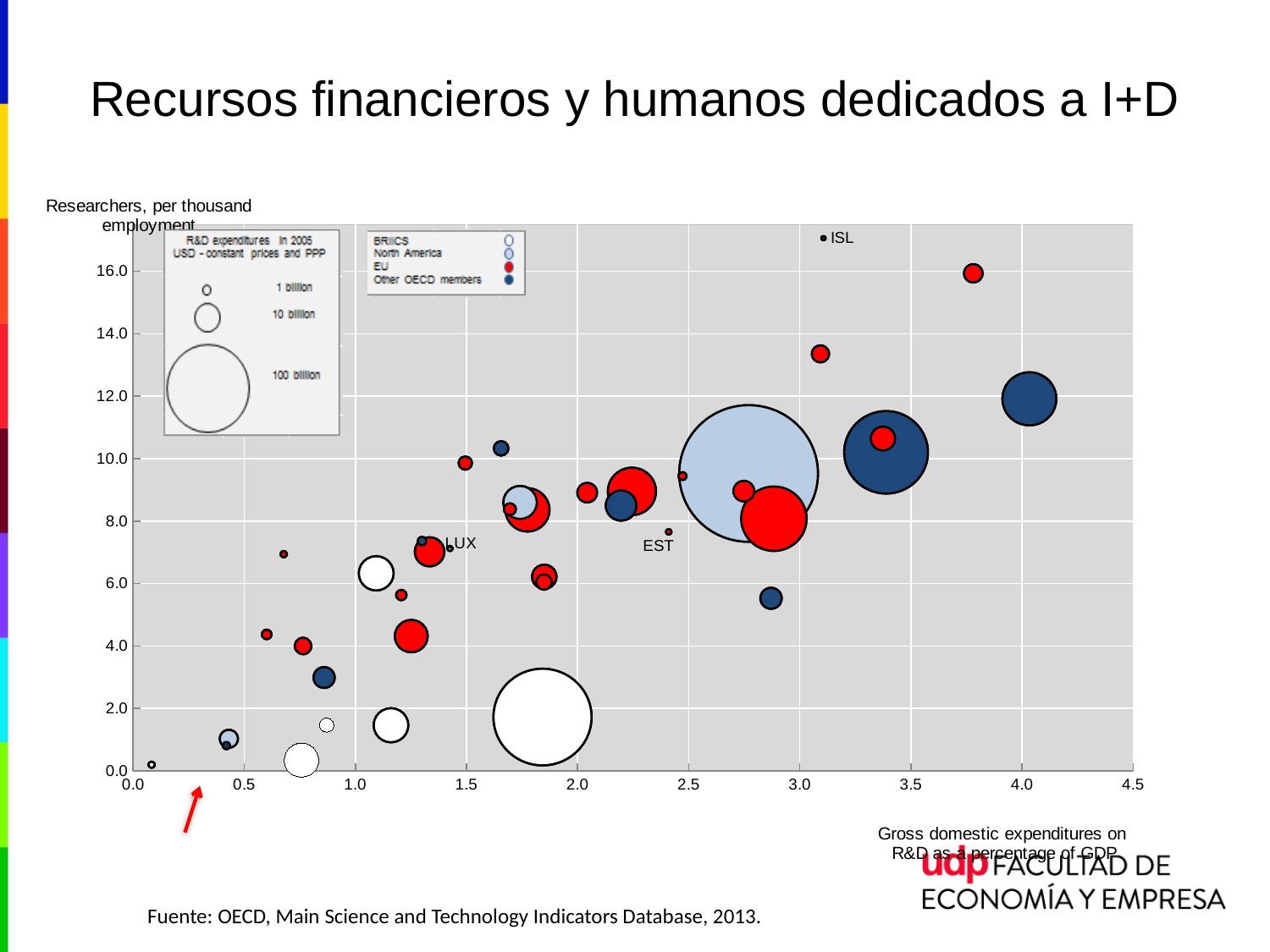
Is the R&D expenditure as a percentage of GDP for EST greater or less than 2.5? less Which labelled country has the highest number of researchers per thousand employment? ISL Is the R&D expenditure as a percentage of GDP for ISL greater or less than 3.0? greater Do researchers per thousand employment generally rise or fall as R&D expenditure as a percentage of GDP increases? rise What does the horizontal axis of the chart measure? Gross domestic expenditures on R&D as a percentage of GDP Is the researchers-per-thousand-employment value for ISL greater or less than 16.0? greater Which has more researchers per thousand employment, ISL or EST? ISL How many groups does the colour legend of the chart list? 4 What kind of chart is shown on the slide? Bubble chart What is the title of the slide containing the chart? Recursos financieros y humanos dedicados a I+D